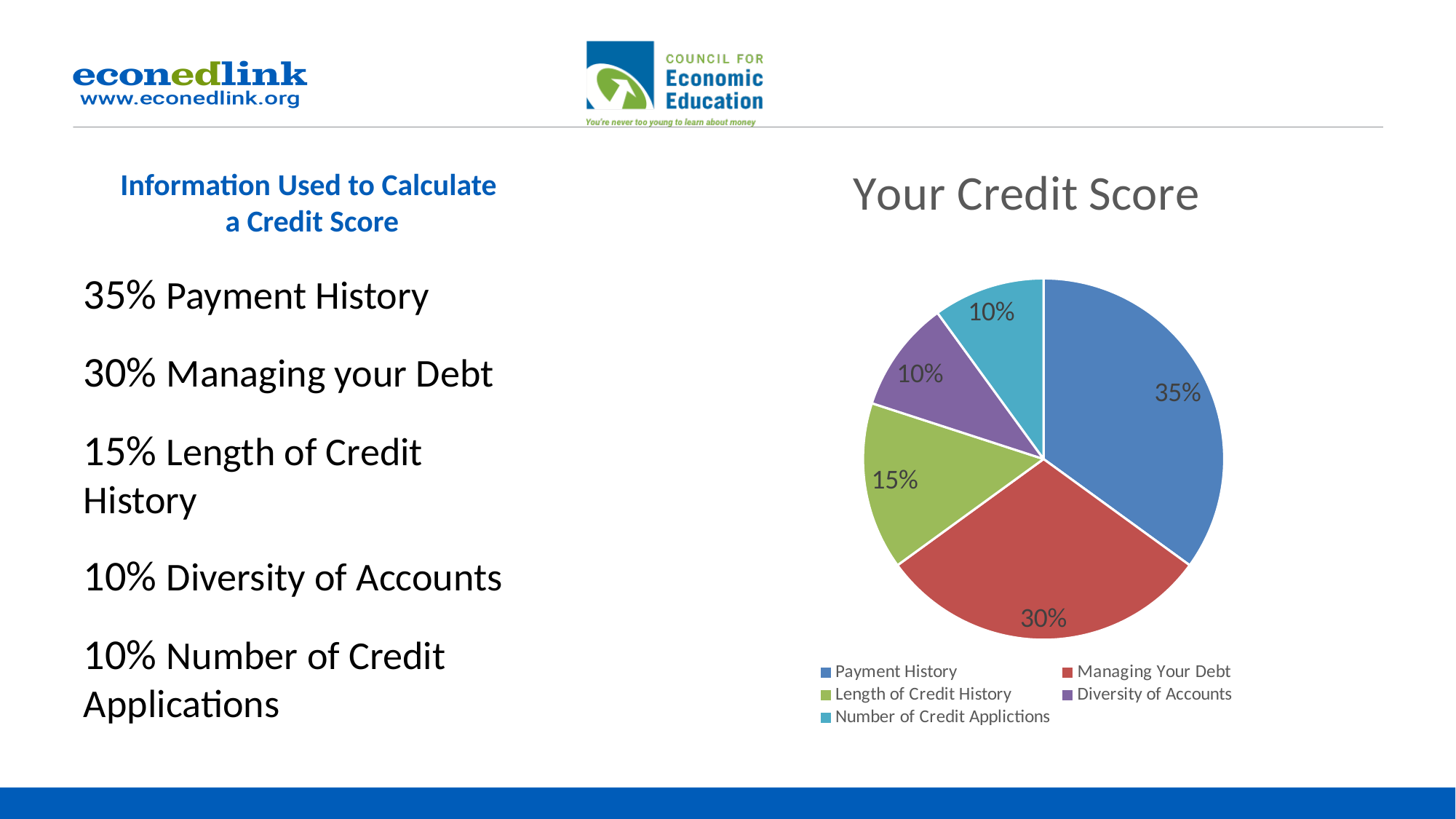
What is the difference between the Managing Your Debt and Length of Credit History slices? 15% Which is larger, the Length of Credit History slice or the Diversity of Accounts slice? Length of Credit History What is the value for Diversity of Accounts? 10% What is the value for Length of Credit History? 15% What share of the pie does Payment History represent? 35% What is the title of the chart? Your Credit Score How many entries does the legend list? 5 How many categories does the pie chart have? 5 What type of chart is shown on the slide? Pie chart What share of the pie does Managing Your Debt represent? 30% Which category has the largest slice of the pie? Payment History What is the difference between the Payment History and Managing Your Debt slices? 5%